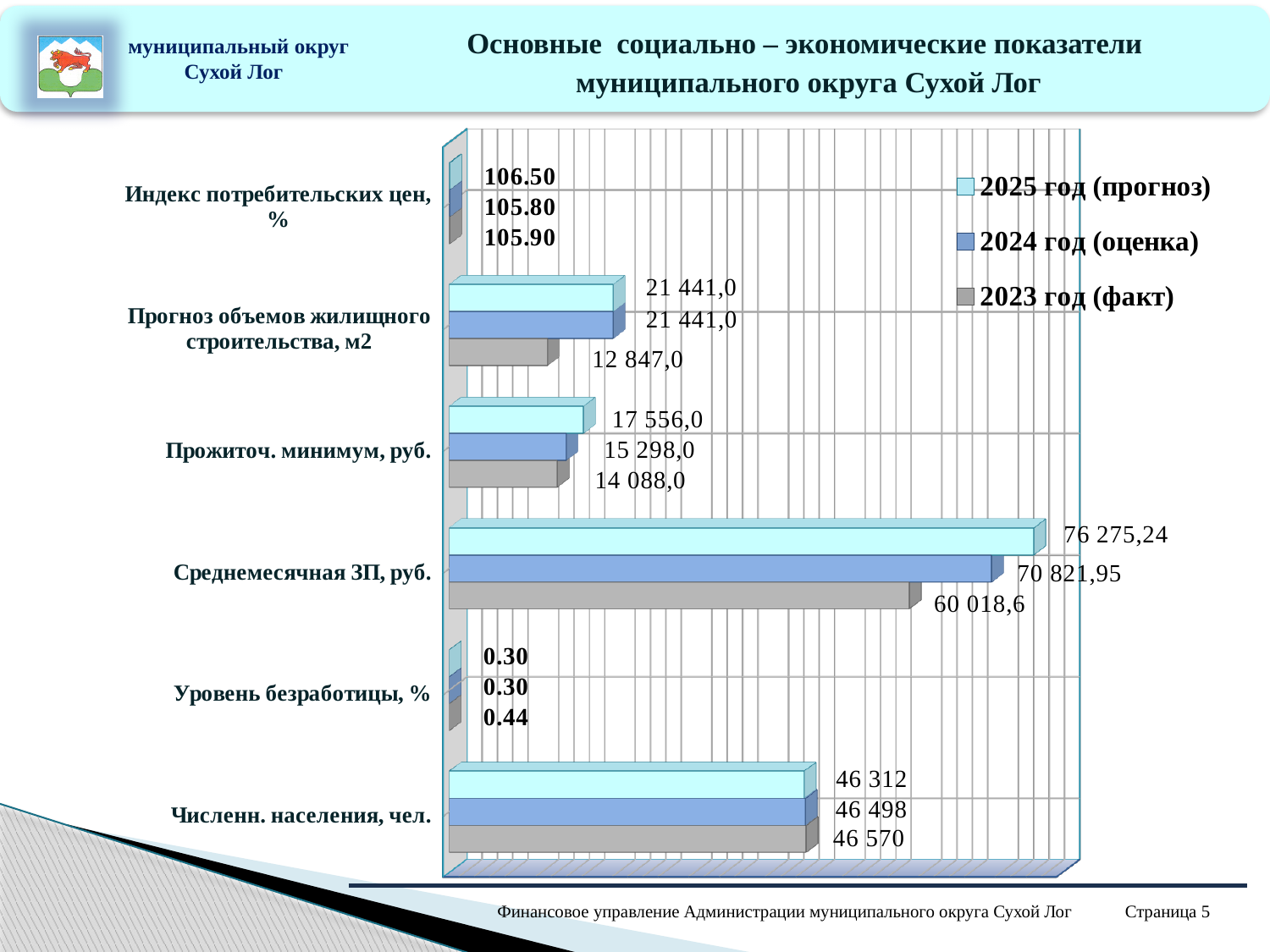
How many series does the legend list? 3 What is the value for Уровень безработицы, % in the 2023 год (факт) series? 0.44 Which is larger for Индекс потребительских цен, %: the 2024 год (оценка) value or the 2023 год (факт) value? 2023 год (факт) What is the difference between the 2023 год (факт) and 2025 год (прогноз) values for Численн. населения, чел.? 258 Which year has the lowest value for Прогноз объемов жилищного строительства, м2? 2023 год (факт) What is the value for Среднемесячная ЗП, руб. in the 2025 год (прогноз) series? 76 275,24 Which year has the highest value for Среднемесячная ЗП, руб.? 2025 год (прогноз) What is the value for Индекс потребительских цен, % in the 2025 год (прогноз) series? 106.50 What is the difference between the 2025 год (прогноз) and 2024 год (оценка) values for Прожиточ. минимум, руб.? 2 258,0 What kind of chart is shown on the slide? Bar chart What is the value for Численн. населения, чел. in the 2024 год (оценка) series? 46 498 What is the value for Прожиточ. минимум, руб. in the 2023 год (факт) series? 14 088,0